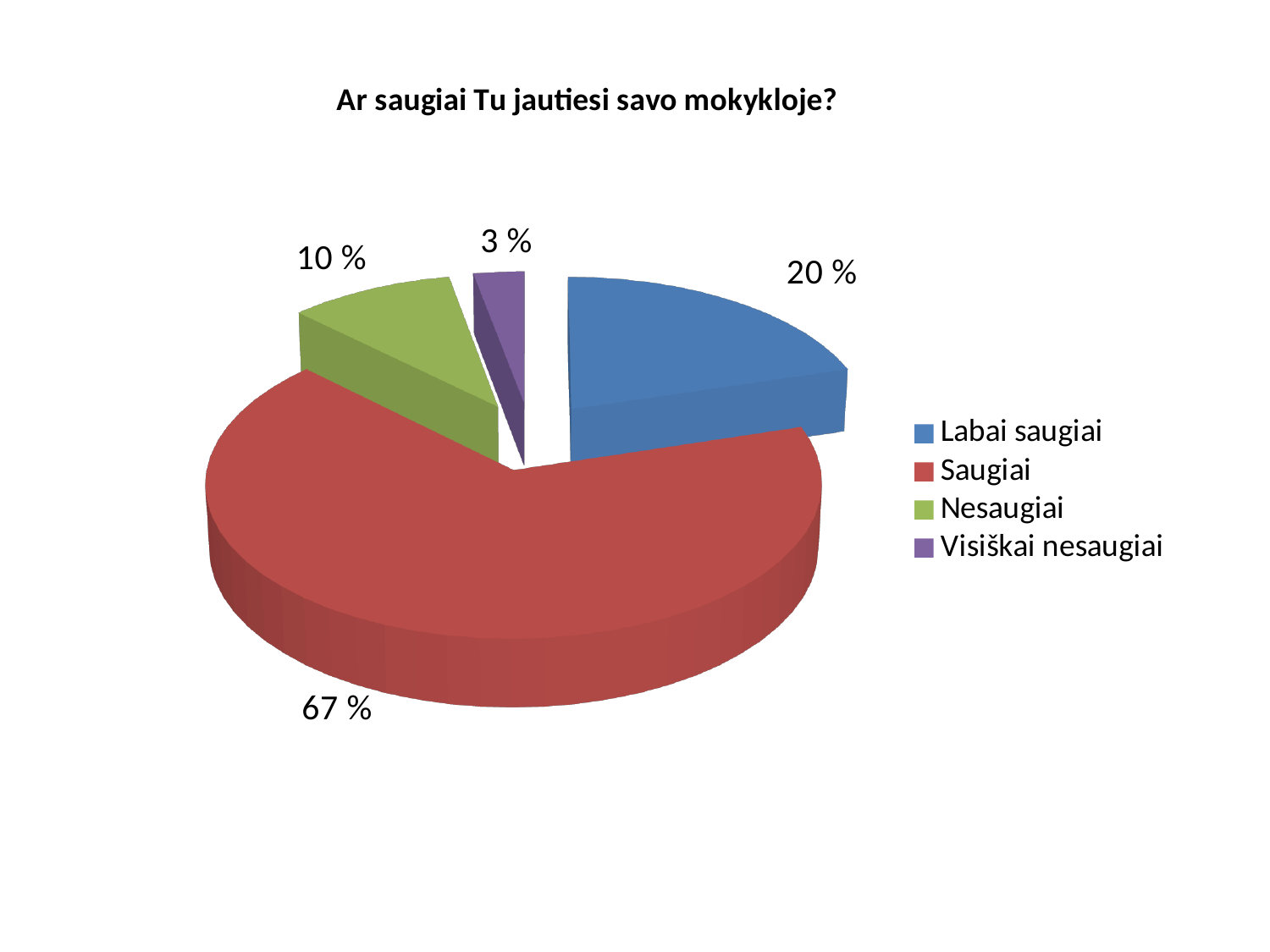
Which category has the largest slice of the pie? Saugiai What is the difference between the values for "Nesaugiai" and "Visiškai nesaugiai"? 7 % What is the value shown for "Visiškai nesaugiai"? 3 % How many categories does the pie chart show? 4 Which is larger, the value for "Labai saugiai" or the value for "Nesaugiai"? Labai saugiai Which category has the smallest slice of the pie? Visiškai nesaugiai What is the title of the chart? Ar saugiai Tu jautiesi savo mokykloje? What share of the pie does "Saugiai" represent? 67 % What is the difference between the values for "Saugiai" and "Labai saugiai"? 47 % What is the value shown for "Labai saugiai"? 20 % What is the value shown for "Nesaugiai"? 10 % What kind of chart is shown on the slide? Pie chart